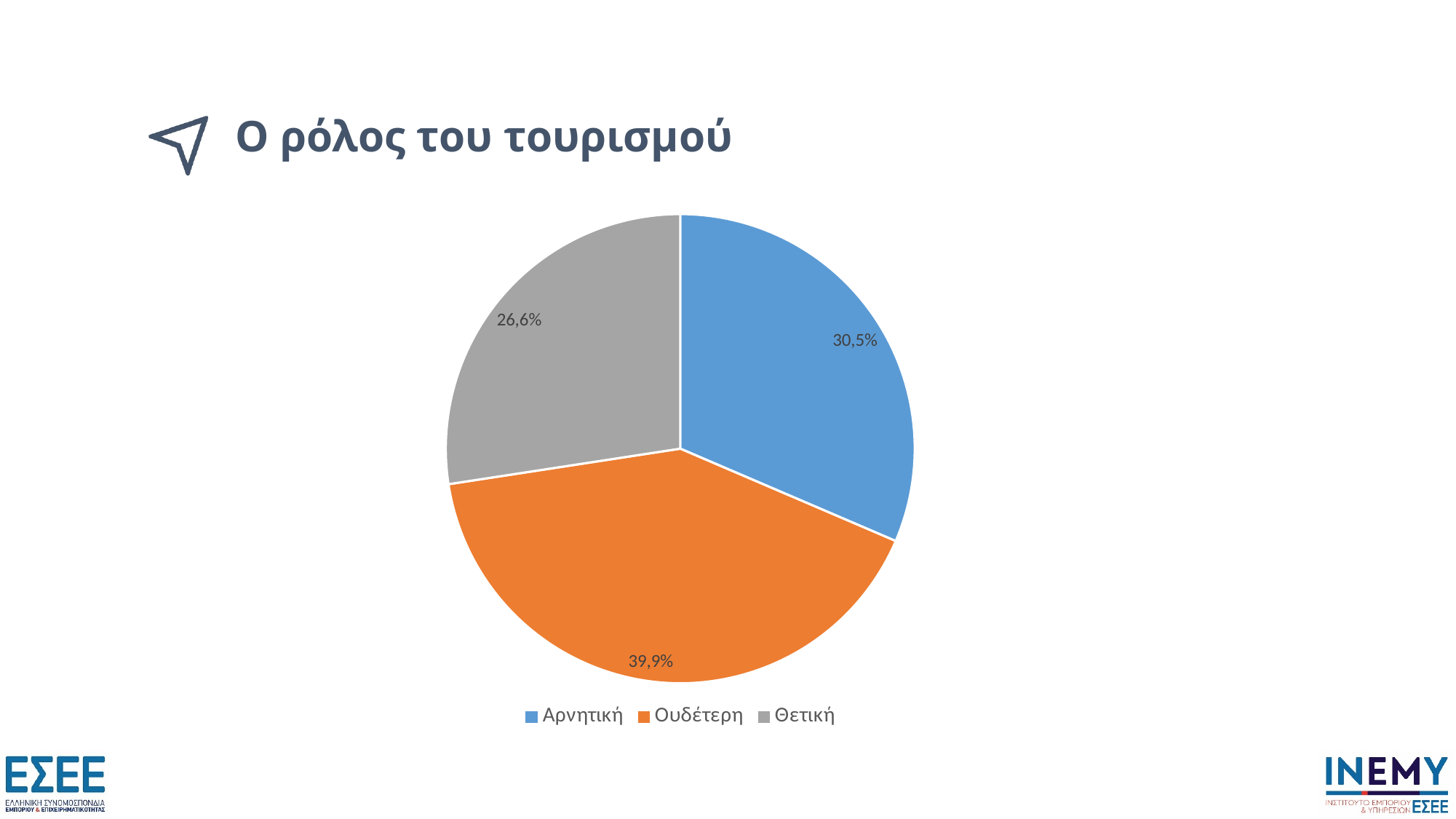
Which category has the smallest share of the pie? Θετική What is the title of the slide containing the chart? Ο ρόλος του τουρισμού What is the difference between the shares of Αρνητική and Θετική? 3,9% What is the value for Ουδέτερη? 39,9% How many slices does the pie chart have? 3 What is the value for Θετική? 26,6% Which category has the largest share of the pie? Ουδέτερη What kind of chart is shown on the slide? pie chart Which is larger, the share of Αρνητική or the share of Θετική? Αρνητική Which colour represents Ουδέτερη in the pie chart? orange What is the difference between the shares of Ουδέτερη and Αρνητική? 9,4% What is the value for Αρνητική? 30,5%